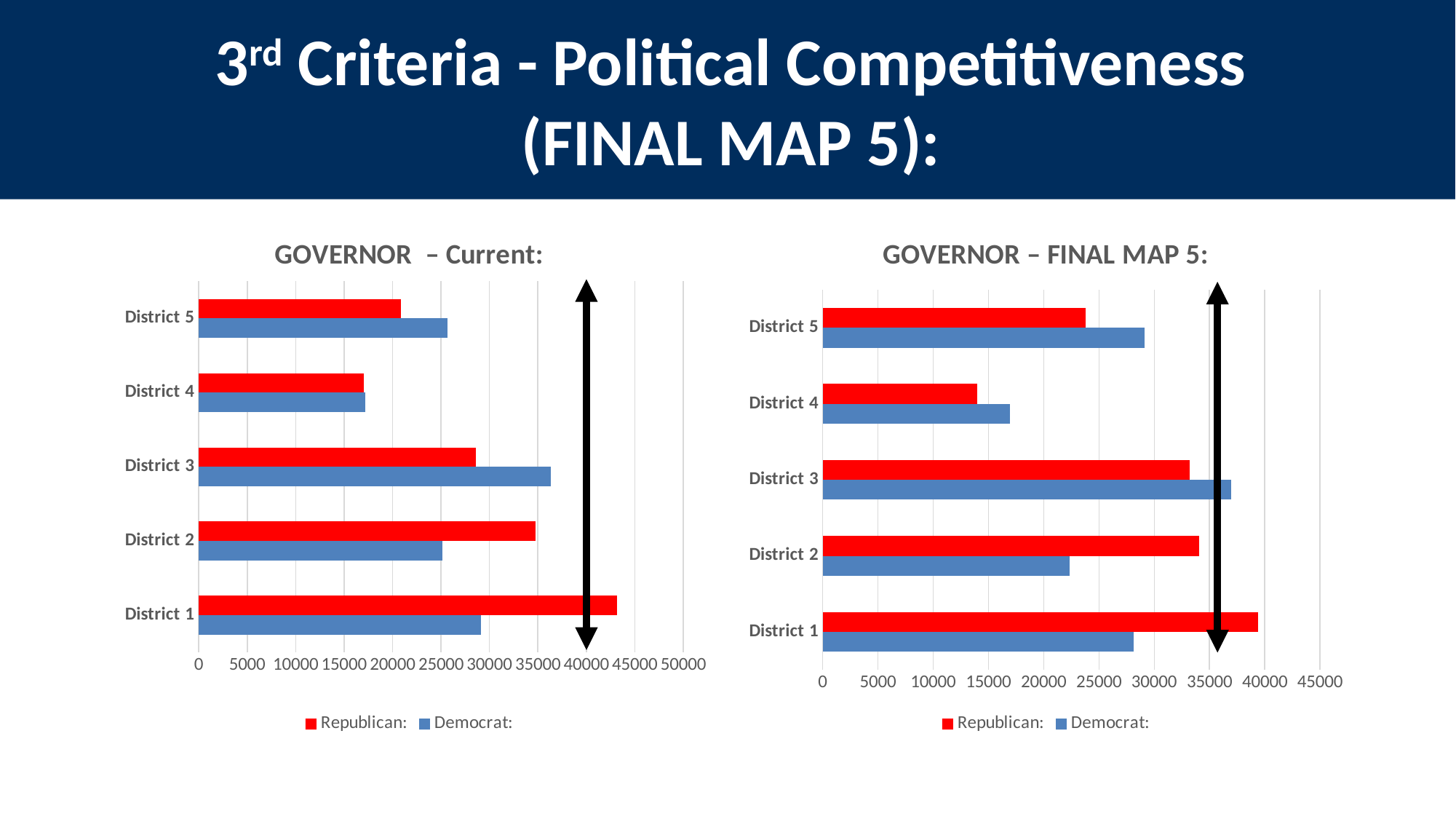
In the GOVERNOR – Current chart, is the Republican value for District 1 greater or less than 40000? greater How many districts are shown in the GOVERNOR – Current chart? 5 In the GOVERNOR – Current chart, which district has the lowest Republican value? District 4 In the GOVERNOR – FINAL MAP 5 chart, which district has the highest Democrat value? District 3 What kind of chart is the GOVERNOR – Current chart on the left? bar chart How many series does the legend of the GOVERNOR – FINAL MAP 5 chart list? 2 In the GOVERNOR – Current chart, which district has the highest Republican value? District 1 In the GOVERNOR – FINAL MAP 5 chart, is the Democrat value for District 2 greater or less than 25000? less What are the two legend entries in the GOVERNOR – Current chart? Republican and Democrat In the GOVERNOR – Current chart, which is larger for District 2, the Republican value or the Democrat value? Republican In the GOVERNOR – FINAL MAP 5 chart, which district has the lowest Democrat value? District 4 In the GOVERNOR – FINAL MAP 5 chart, which is larger for District 5, the Republican value or the Democrat value? Democrat